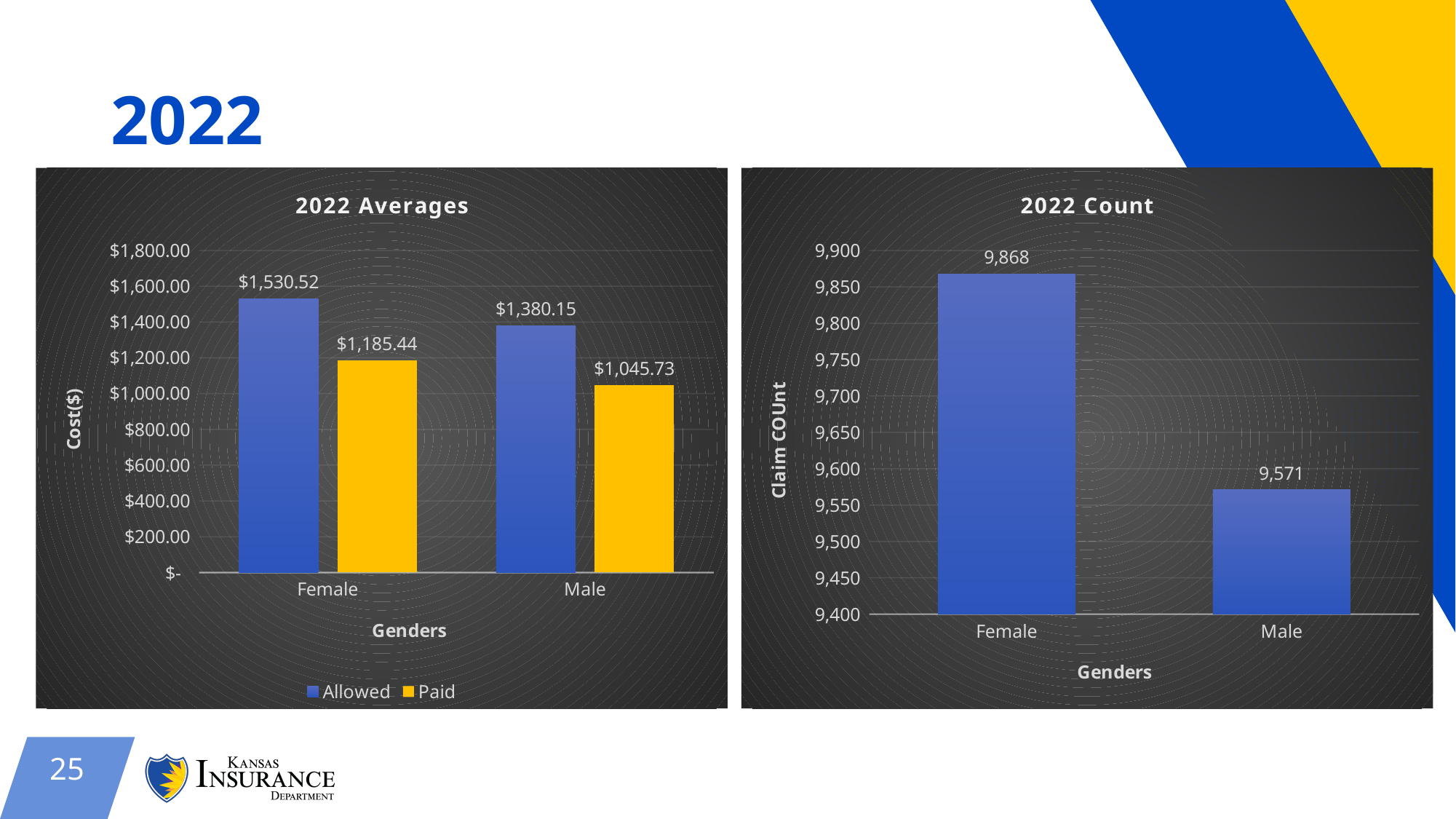
In the '2022 Averages' chart, what is the difference between the Allowed and Paid values for Male? $334.42 In the '2022 Averages' chart, what is the Allowed value for Female? $1,530.52 In the '2022 Averages' chart, how many series does the legend list? 2 In the '2022 Count' chart, what is the claim count for Female? 9,868 In the '2022 Averages' chart, what is the Paid value for Male? $1,045.73 What kind of chart is the '2022 Count' chart? Bar chart In the '2022 Averages' chart, what is the Paid value for Female? $1,185.44 In the '2022 Count' chart, which gender has the lowest claim count? Male In the '2022 Count' chart, what is the difference between the Female and Male claim counts? 297 In the '2022 Averages' chart, which gender has the higher Allowed average? Female In the '2022 Count' chart, what is the claim count for Male? 9,571 In the '2022 Averages' chart, which colour represents the Paid series? Yellow